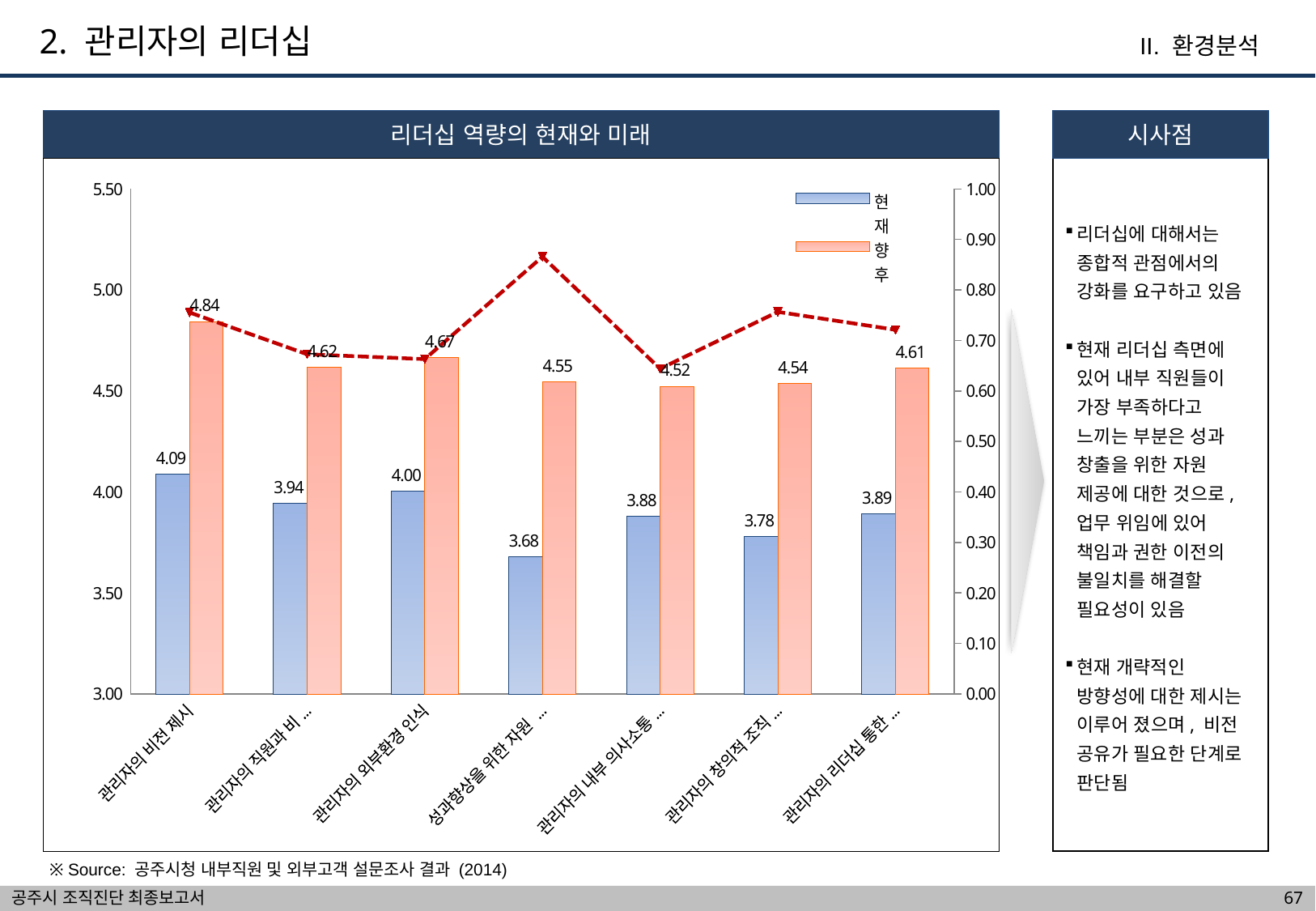
What is the title of the chart? 리더십 역량의 현재와 미래 How many series does the legend list? 2 What is the 현재 value for 관리자의 비전 제시? 4.09 What is the 현재 value for 관리자의 외부환경 인식? 4.00 What is the 향후 value for 관리자의 비전 제시? 4.84 How many categories are shown on the x axis of the chart? 7 What is the 향후 value for 관리자의 외부환경 인식? 4.67 What is the lowest 현재 value shown on the chart? 3.68 Which category has the highest 현재 value? 관리자의 비전 제시 Is the 현재 value for 관리자의 외부환경 인식 greater or less than 4.50? less What is the difference between the 향후 and 현재 values for 관리자의 비전 제시? 0.75 Which is larger for 관리자의 외부환경 인식, the 현재 value or the 향후 value? 향후